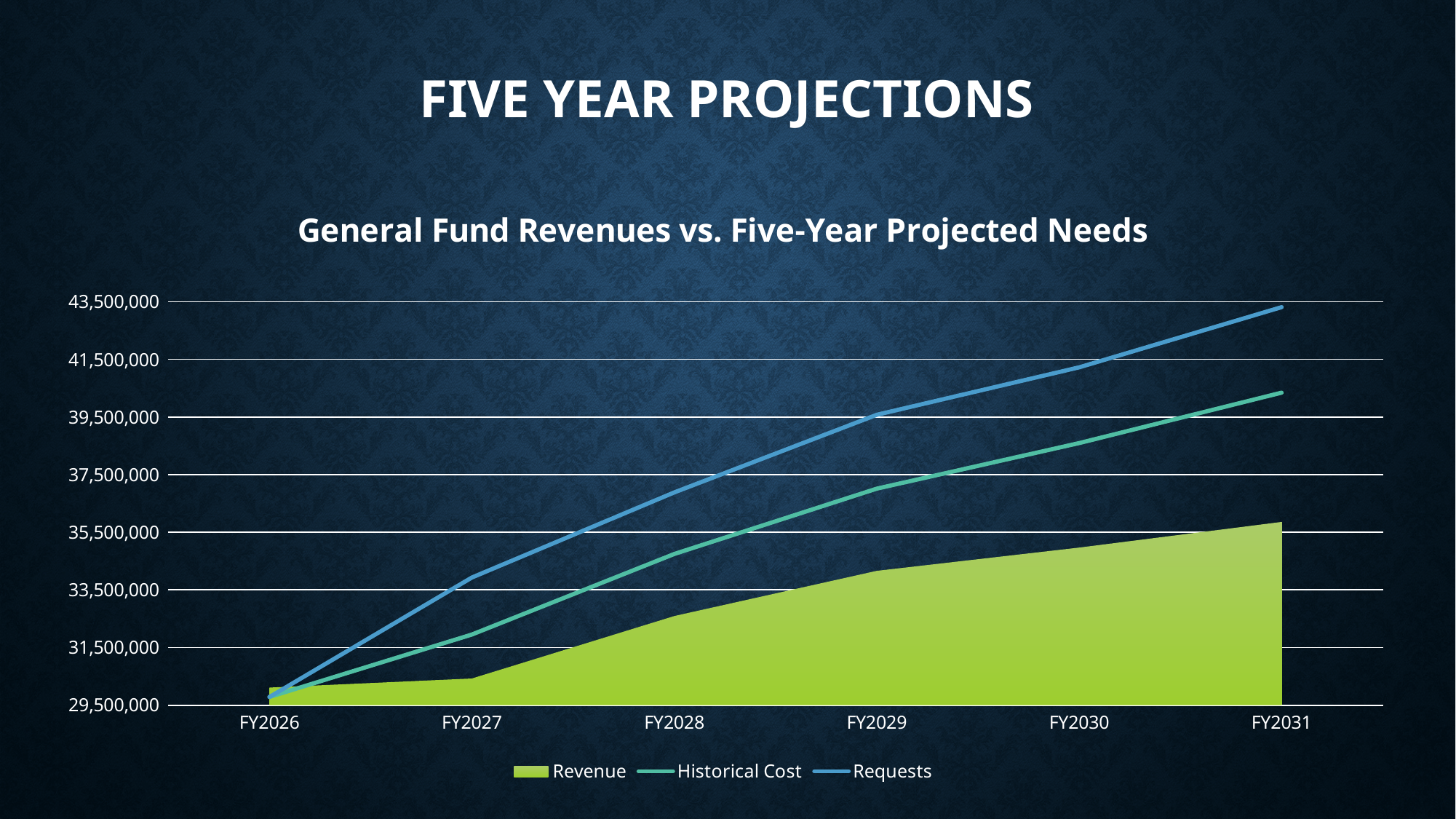
Is the value for Historical Cost in FY2028 greater or less than 35,500,000? less Is the value for Revenue in FY2031 greater or less than 37,500,000? less Is the value for Revenue in FY2026 greater or less than 31,500,000? less Which series is drawn as a filled green area rather than a line? Revenue How many series does the legend list? 3 In FY2031, which series has the higher value, Requests or Historical Cost? Requests What is the title of the chart? General Fund Revenues vs. Five-Year Projected Needs In FY2030, which series has the higher value, Revenue or Historical Cost? Historical Cost How many fiscal years are shown on the x axis? 6 Do the Requests values rise or fall from FY2026 to FY2031? rise